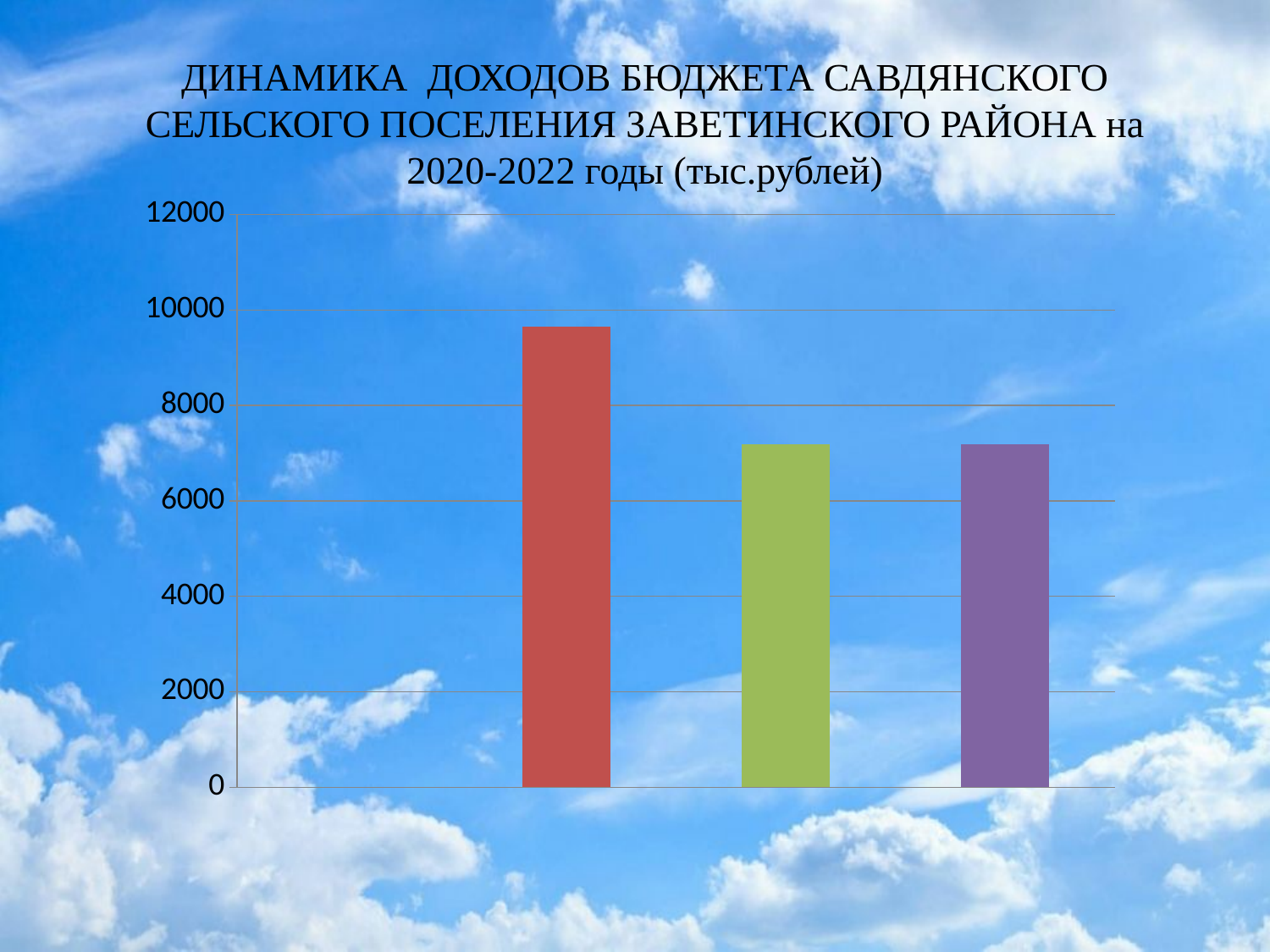
Is the value of the first (red) bar greater or less than 8000? greater Is the value of the third (purple) bar greater or less than 6000? greater What kind of chart is shown on the slide? bar chart Which is larger, the first (red) bar or the second (green) bar? the first (red) bar Is the value of the second (green) bar greater or less than 8000? less How many bars are plotted in the chart? 3 Which bar is the tallest in the chart? the first (red) bar What is the highest value shown on the vertical axis? 12000 In what units are the values in the chart expressed, according to the title? тыс.рублей Does the value fall or rise from the first bar to the second bar? fall